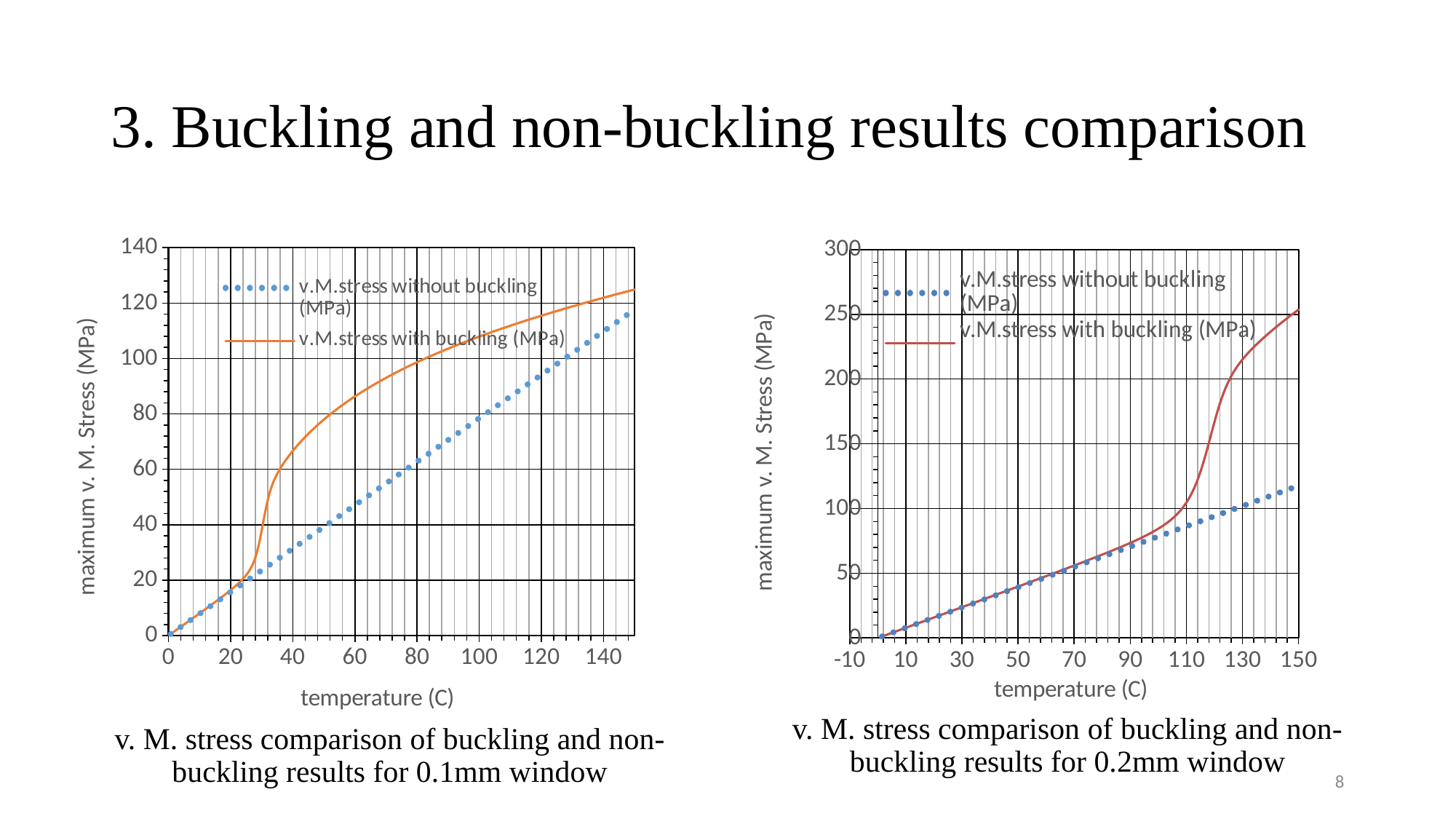
In the right chart (0.2mm window), is the value of v.M.stress without buckling (MPa) at 150 C greater or less than 150? less In the right chart (0.2mm window), does v.M.stress with buckling (MPa) rise or fall as temperature increases? rise In the right chart (0.2mm window), is the value of v.M.stress with buckling (MPa) at 140 C greater or less than 200? greater In the left chart (0.1mm window), what is the label of the x axis? temperature (C) What kind of chart is the left chart (0.1mm window)? line chart In the right chart (0.2mm window), what is the label of the y axis? maximum v. M. Stress (MPa) How many series does the legend of the right chart (0.2mm window) list? 2 In the right chart (0.2mm window), which series has the larger value at 130 C: v.M.stress with buckling (MPa) or v.M.stress without buckling (MPa)? v.M.stress with buckling (MPa) In the left chart (0.1mm window), does v.M.stress without buckling (MPa) rise or fall as temperature increases? rise In the left chart (0.1mm window), which series has the larger value at 140 C: v.M.stress with buckling (MPa) or v.M.stress without buckling (MPa)? v.M.stress with buckling (MPa) In the left chart (0.1mm window), is the value of v.M.stress without buckling (MPa) at 60 C greater or less than 60? less